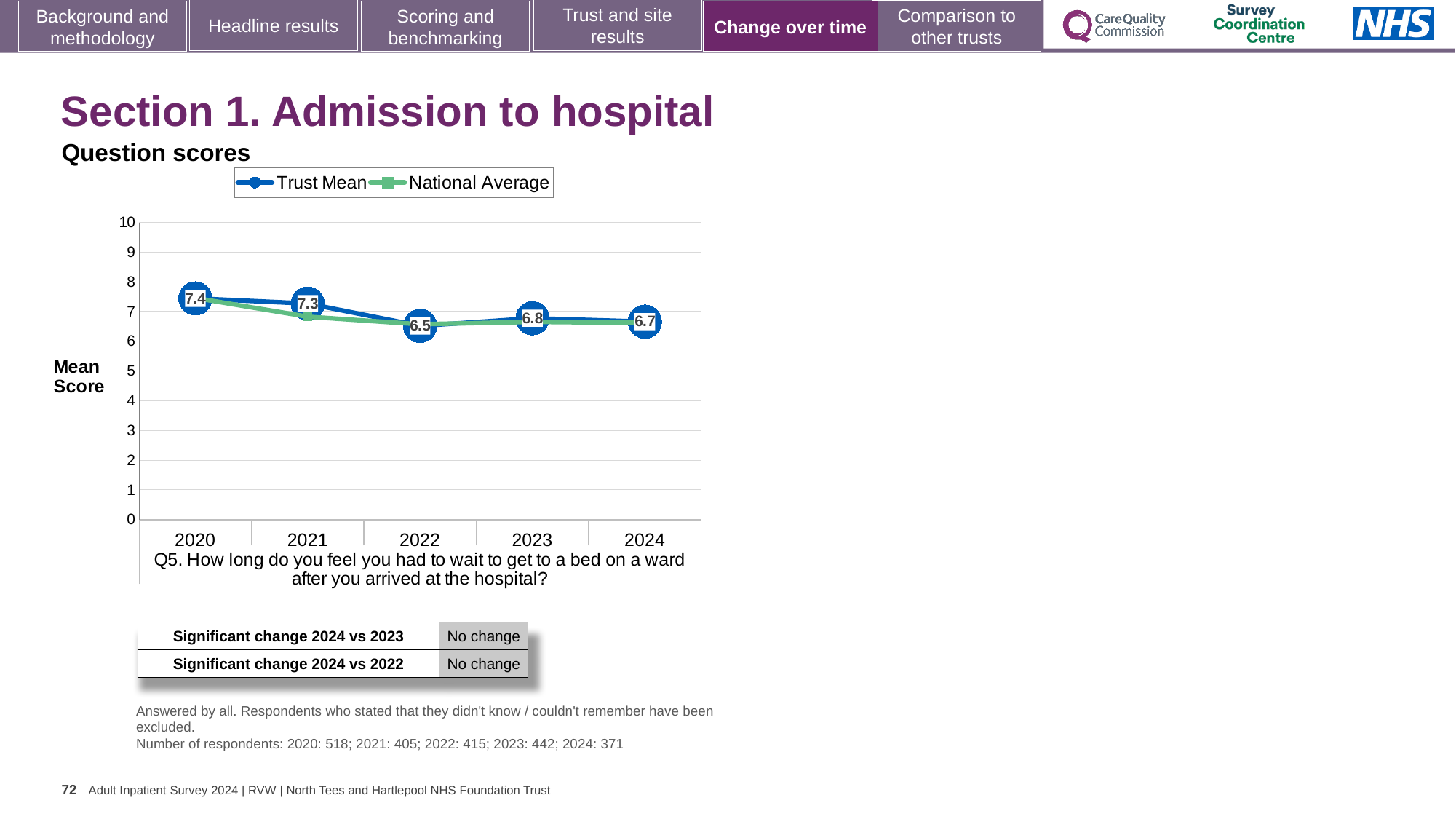
Is the National Average value for 2021 greater or less than 7? less What kind of chart is shown on the slide? Line chart In which year is the Trust Mean score highest? 2020 Does the Trust Mean score rise or fall from 2020 to 2022? fall What is the Trust Mean score for 2022? 6.5 What is the Trust Mean score for 2024? 6.7 What is the Trust Mean score for 2020? 7.4 How many series does the legend list? 2 How many years are plotted on the x axis? 5 In which year is the Trust Mean score lowest? 2022 Which year has the larger Trust Mean score, 2021 or 2023? 2021 What is the difference between the Trust Mean score in 2020 and in 2022? 0.9